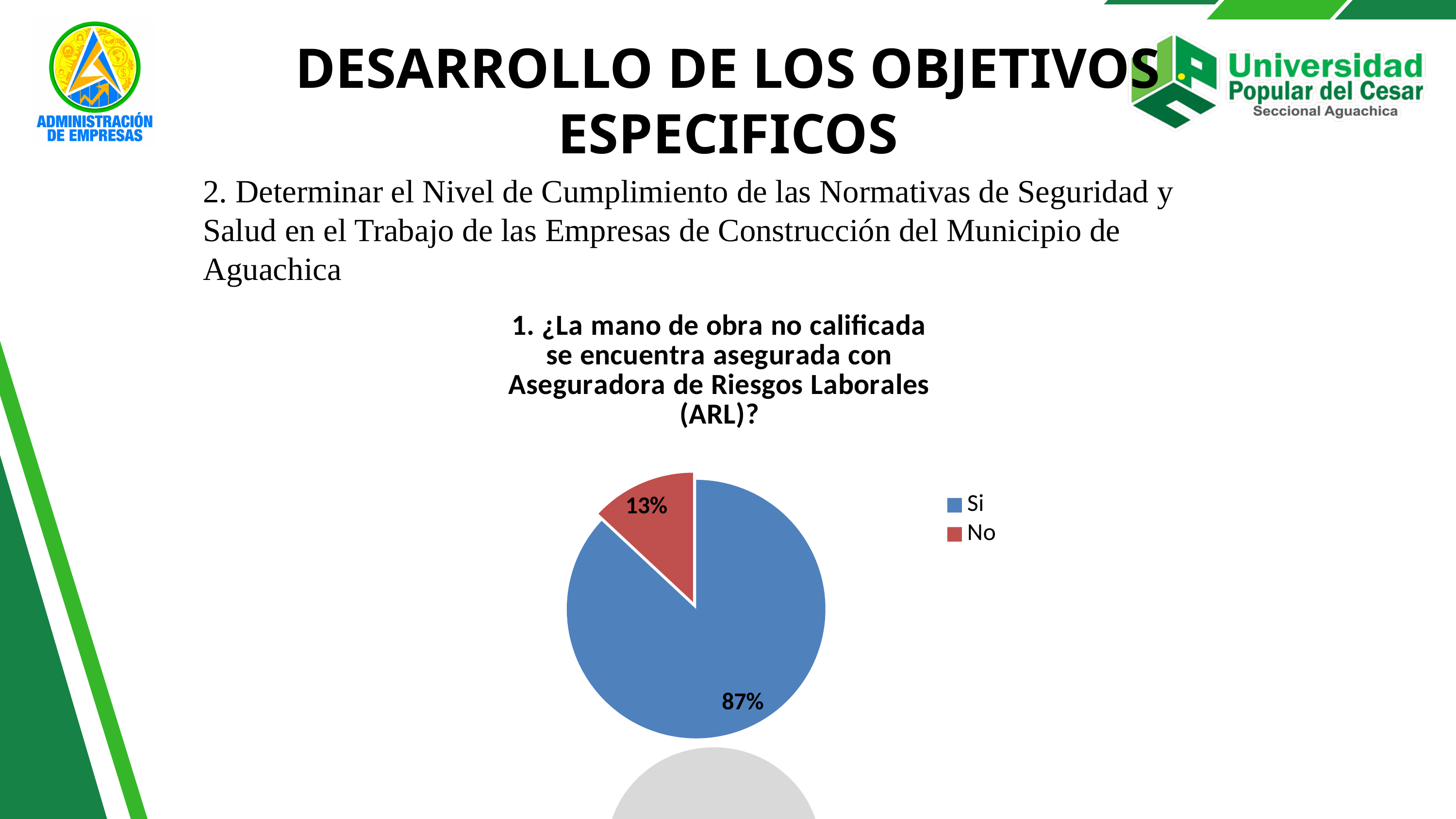
What share of the pie does the "No" slice represent? 13% How many entries does the legend list? 2 What colour is the "No" slice in the pie chart? Red Which category has the smallest slice of the pie? No How many categories are shown in the pie chart? 2 Which is larger, the "Si" slice or the "No" slice? Si What is the title of the pie chart? 1. ¿La mano de obra no calificada se encuentra asegurada con Aseguradora de Riesgos Laborales (ARL)? Which category has the largest slice of the pie? Si What share of the pie does the "Si" slice represent? 87% What kind of chart is shown on the slide? Pie chart What is the difference in percentage points between the "Si" and "No" slices? 74%